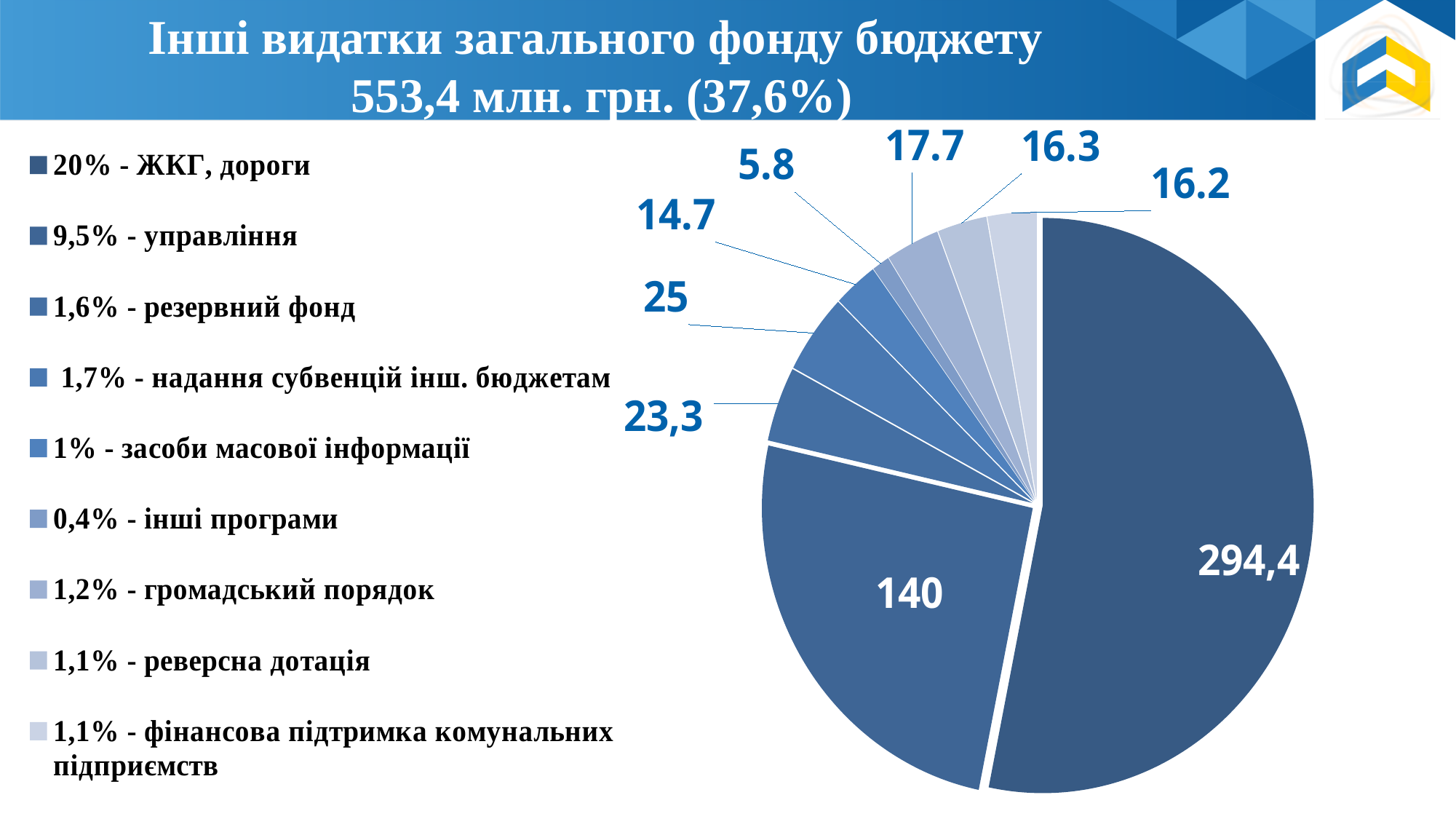
What value is shown for the slice labelled 'управління' (9,5%)? 140 What value is shown for the slice labelled 'надання субвенцій інш. бюджетам' (1,7%)? 25 How many entries does the legend list? 9 How many slices does the pie chart have? 9 What kind of chart is shown on the slide? pie chart Which slice is larger: the one labelled 17.7 or the one labelled 16.3? 17.7 What value is shown for the slice labelled 'резервний фонд' (1,6%)? 23,3 What is the difference between the two largest slices, 294,4 and 140? 154,4 What is the value of the smallest slice of the pie chart? 5.8 According to the legend, what share of the total does 'ЖКГ, дороги' represent? 20% What is the value of the largest slice of the pie chart? 294,4 What total amount is stated in the slide title? 553,4 млн. грн. (37,6%)